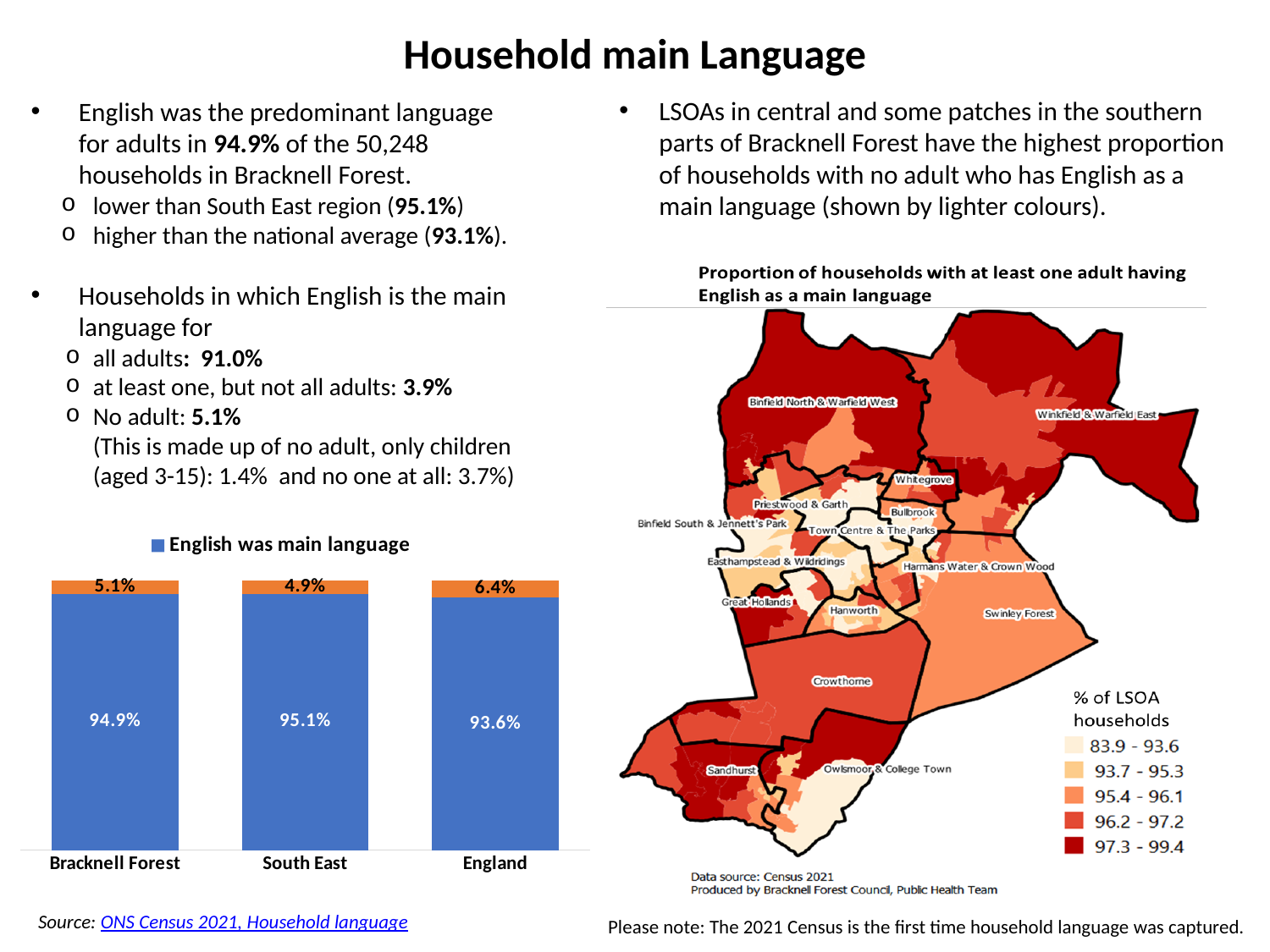
In the bar chart, what is the value of the blue 'English was main language' segment for South East? 95.1% In the bar chart, what percentage of households in Bracknell Forest had English as the main language? 94.9% In the bar chart, what is the difference between the orange segment values for England and South East? 1.5% In the bar chart, which category has the highest value for 'English was main language'? South East In the bar chart, which category has the lowest value for 'English was main language'? England In the bar chart, what is the value of the orange top segment for England? 6.4% How many series does the legend of the bar chart list? 1 In the bar chart, what is the value of the blue segment for England? 93.6% In the bar chart, which has a larger 'English was main language' value, Bracknell Forest or England? Bracknell Forest In the bar chart, what is the difference between the 'English was main language' values for South East and Bracknell Forest? 0.2% How many categories are shown on the x axis of the bar chart? 3 What type of chart is shown in the bottom left of the slide? Stacked bar chart